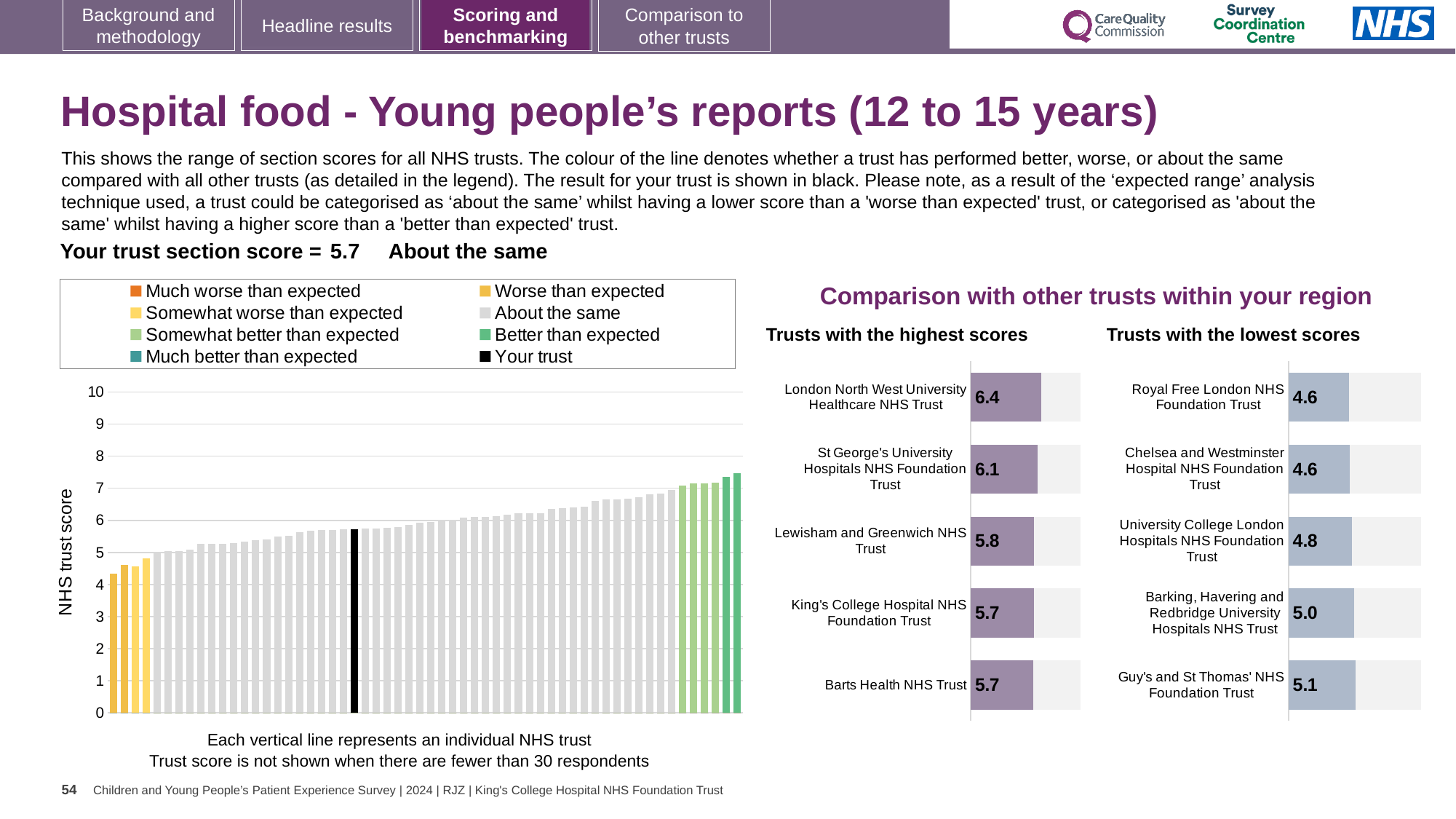
In the NHS trust score chart on the left, is the value for the black 'Your trust' bar greater or less than 6? less How many entries does the legend of the NHS trust score chart on the left list? 8 In the 'Trusts with the highest scores' chart, what is the score for London North West University Healthcare NHS Trust? 6.4 In the 'Trusts with the highest scores' chart, what is the difference between the scores of London North West University Healthcare NHS Trust and St George's University Hospitals NHS Foundation Trust? 0.3 In the 'Trusts with the lowest scores' chart, which is larger: the score for Barking, Havering and Redbridge University Hospitals NHS Trust or the score for Royal Free London NHS Foundation Trust? Barking, Havering and Redbridge University Hospitals NHS Trust How many trusts are listed in the 'Trusts with the highest scores' chart? 5 In the 'Trusts with the highest scores' chart, what is the score for Lewisham and Greenwich NHS Trust? 5.8 In the 'Trusts with the lowest scores' chart, what is the score for University College London Hospitals NHS Foundation Trust? 4.8 In the 'Trusts with the lowest scores' chart, what is the score for Guy's and St Thomas' NHS Foundation Trust? 5.1 In the 'Trusts with the highest scores' chart, which trust has the highest score? London North West University Healthcare NHS Trust In the 'Trusts with the lowest scores' chart, which trust has the highest score shown? Guy's and St Thomas' NHS Foundation Trust In the NHS trust score chart on the left, do the bar values rise or fall from left to right? rise